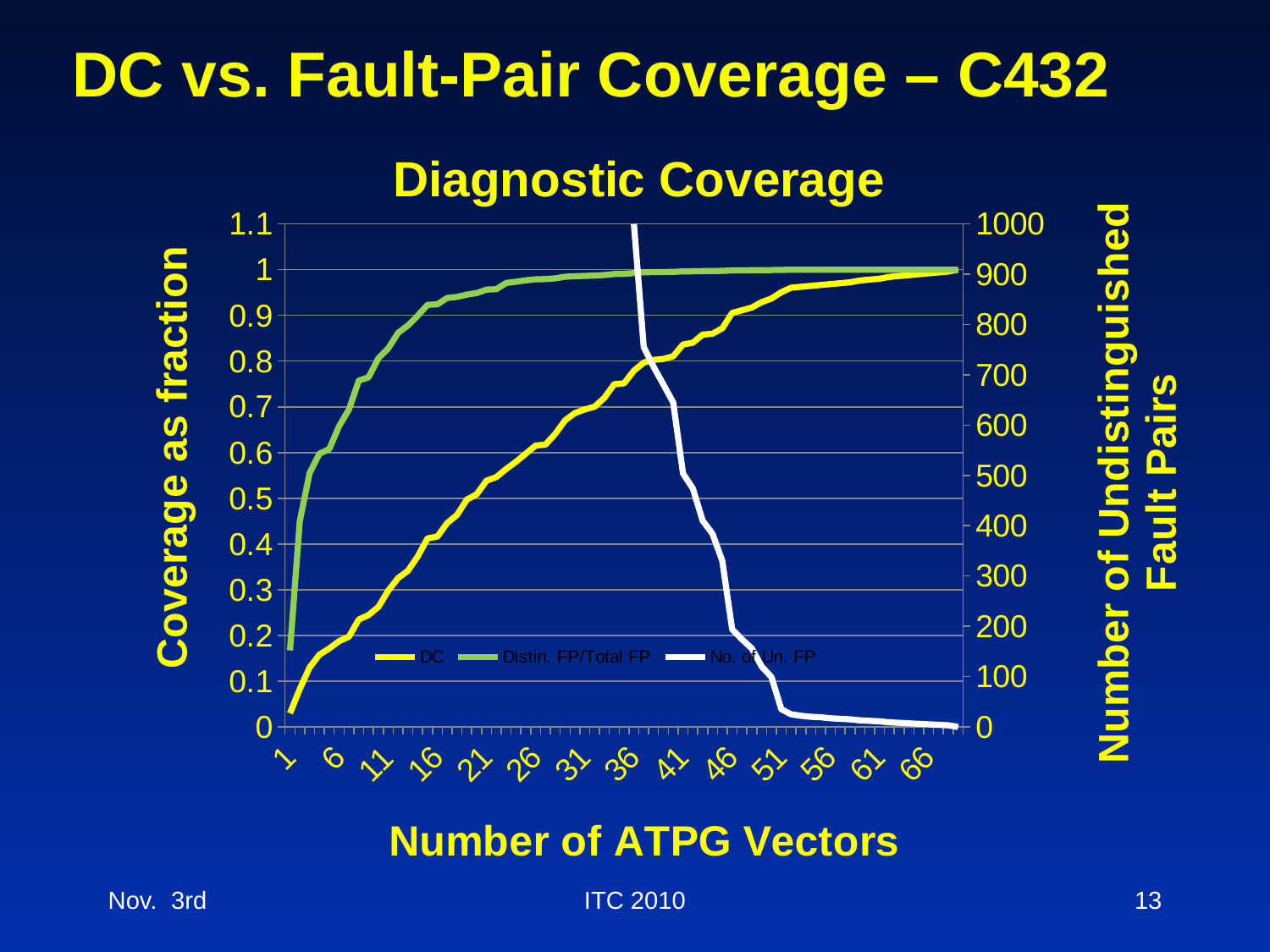
What kind of chart is shown on the slide? line chart How many series does the legend of the chart list? 3 At 11 ATPG vectors, which series has the higher value, DC or Distin. FP/Total FP? Distin. FP/Total FP Does the DC series rise or fall as the number of ATPG vectors increases? rise Is the DC value at 1 ATPG vector greater or less than 0.1? less What is the title of the chart? Diagnostic Coverage Does the No. of Un. FP series rise or fall as the number of ATPG vectors increases? fall Is the No. of Un. FP value at 56 ATPG vectors greater or less than 100? less Is the Distin. FP/Total FP value at 21 ATPG vectors greater or less than 0.9? greater What is the label of the x axis of the chart? Number of ATPG Vectors